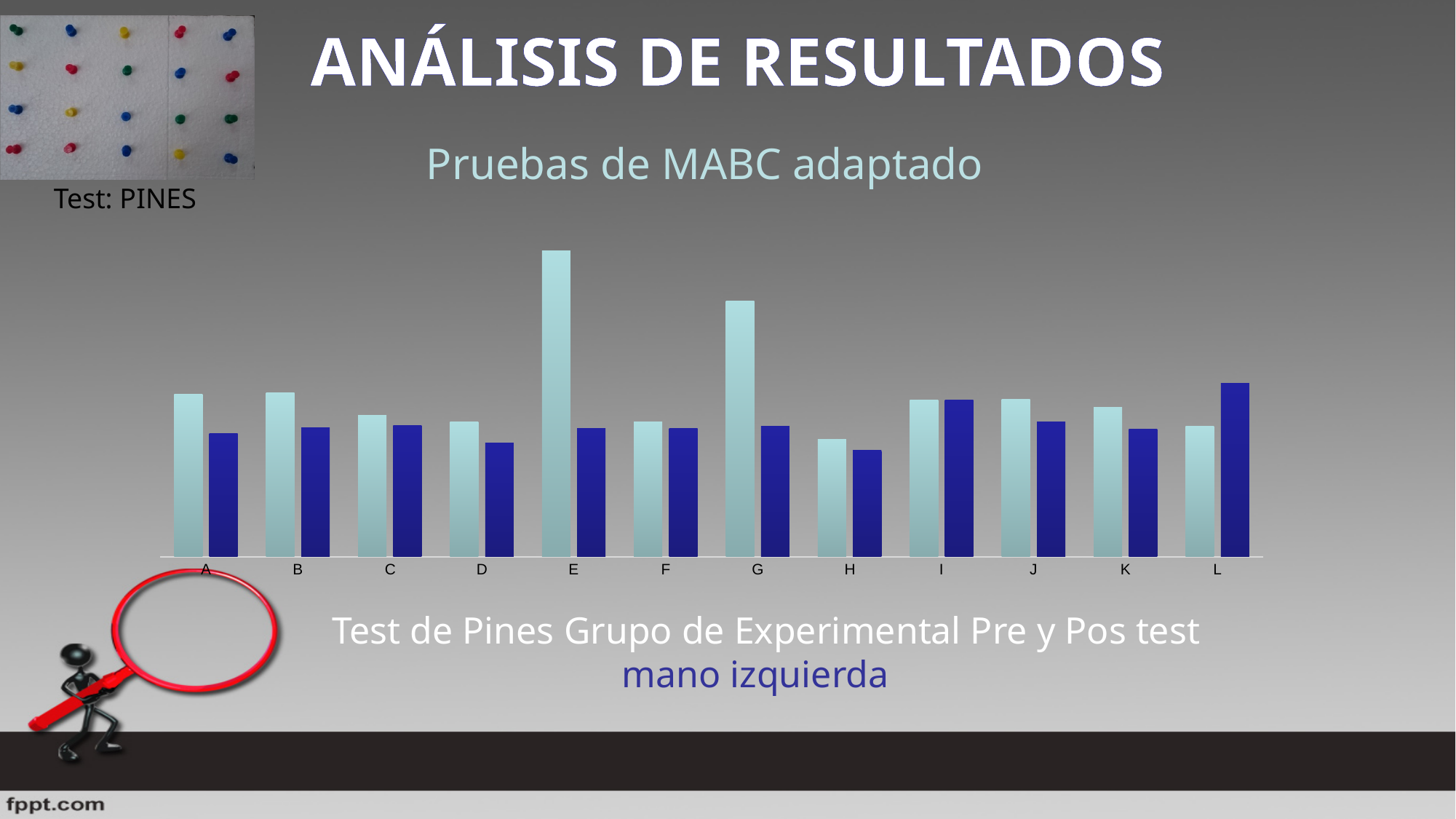
How many categories are shown along the x axis of the chart? 12 Which category has the shortest light blue bar? H Which category has the taller light blue bar, E or G? E Which category has the taller dark blue bar, L or A? L What kind of chart is shown on the slide? bar chart What is the first letter and the last letter of the category labels on the x axis? A and L Which category has the tallest dark blue bar? L Which category has the tallest light blue bar? E How many bars are plotted for each category in the chart? 2 For category E, which bar is taller, the light blue one or the dark blue one? the light blue one What caption appears below the chart? Test de Pines Grupo de Experimental Pre y Pos test mano izquierda